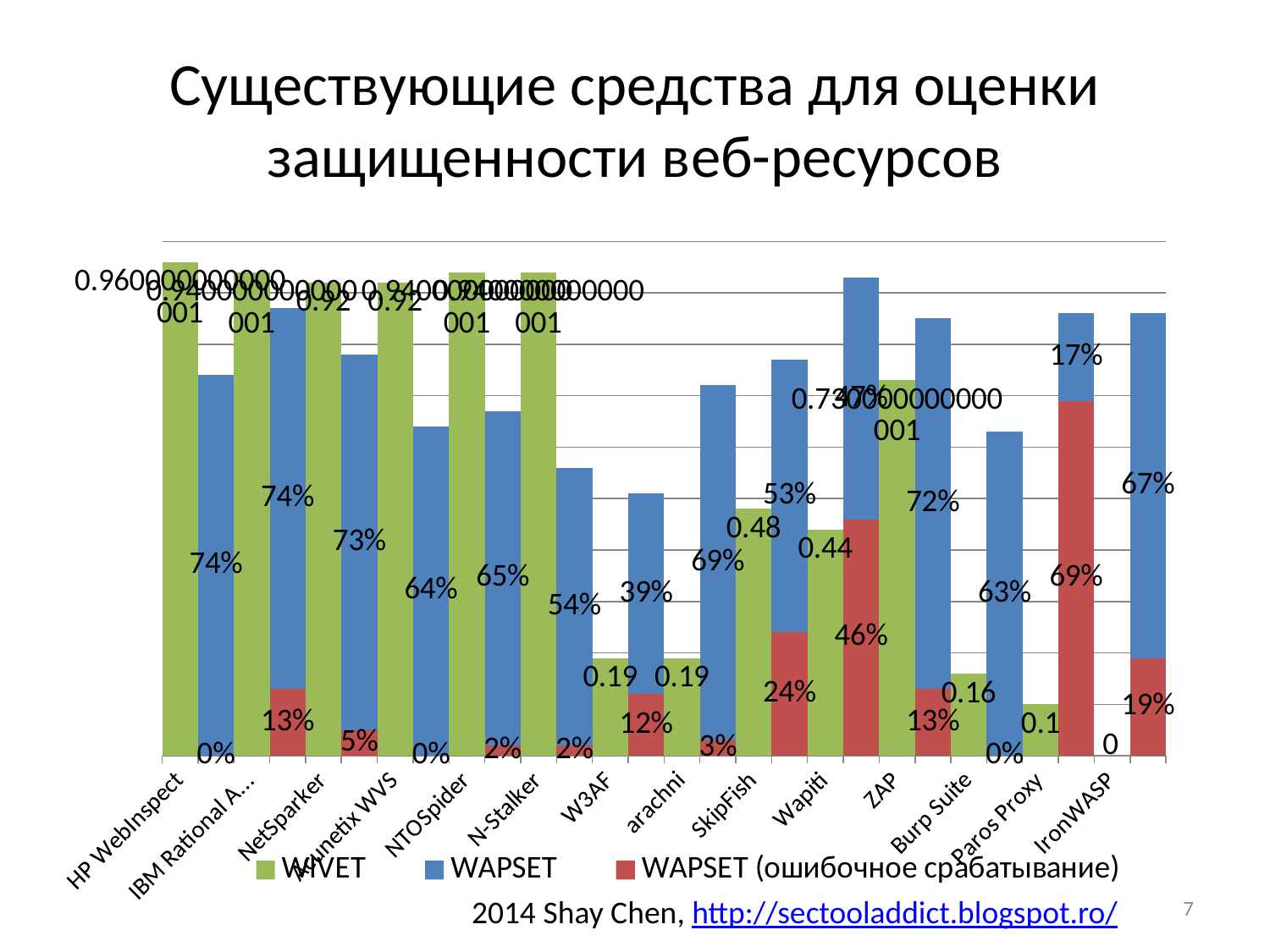
Which tool has the highest WAPSET (ошибочное срабатывание) value? Paros Proxy What kind of chart is shown on the slide? bar chart Which tool has the highest WIVET value? HP WebInspect What is the WIVET value for Paros Proxy? 0.1 What is the WAPSET value for NetSparker? 73% What is the WIVET value for SkipFish? 0.48 What is the name of the third series in the legend? WAPSET (ошибочное срабатывание) How many tools (categories) are shown on the x axis? 14 How many series does the legend list? 3 What is the WAPSET (ошибочное срабатывание) value for Wapiti? 46% Which has the larger WAPSET value, ZAP or Burp Suite? ZAP What is the difference between the WAPSET values for arachni and W3AF? 30%